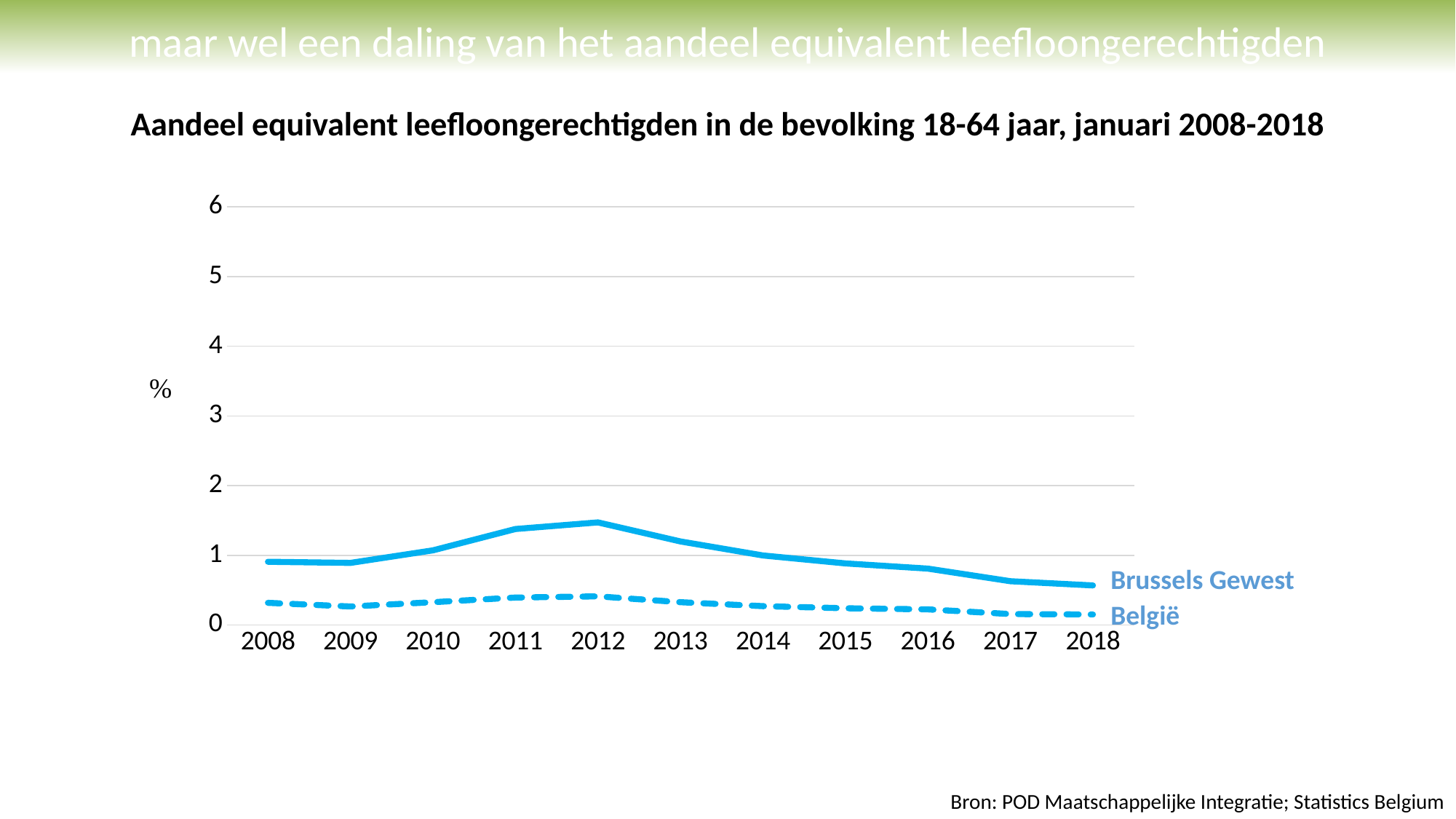
Does the Brussels Gewest line rise or fall between 2009 and 2012? rise What kind of chart is shown on the slide? line chart Is the value for Brussels Gewest in 2018 greater or less than 1? less How many series are plotted on the chart? 2 Does the Brussels Gewest line rise or fall between 2012 and 2018? fall Is the value for België in 2012 greater or less than 1? less How many years are shown on the x axis of the chart? 11 Is the value for Brussels Gewest in 2012 greater or less than 1? greater Which series has the higher value in 2012, Brussels Gewest or België? Brussels Gewest In which year does the Brussels Gewest line reach its highest value? 2012 What unit is shown on the y axis of the chart? % Which series is drawn with a dashed line? België